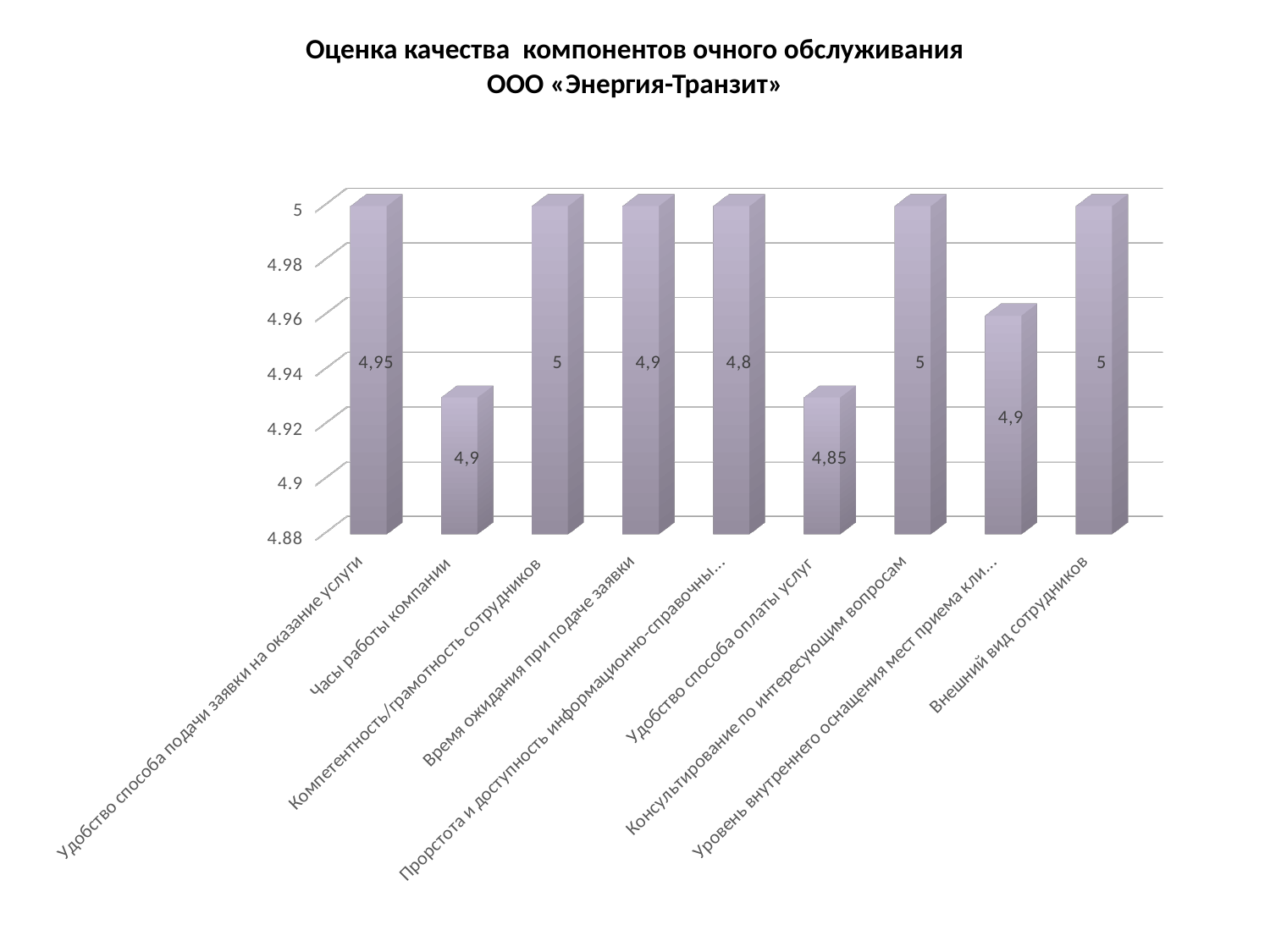
What is the value for «Компетентность/грамотность сотрудников»? 5 What type of chart is shown on the slide? bar chart What is the value for «Удобство способа оплаты услуг»? 4,85 How many categories are plotted in the chart? 9 Which has the larger value: «Компетентность/грамотность сотрудников» or «Удобство способа оплаты услуг»? Компетентность/грамотность сотрудников What is the title of the chart? Оценка качества компонентов очного обслуживания ООО «Энергия-Транзит» What is the value for «Удобство способа подачи заявки на оказание услуги»? 4,95 What is the value for «Время ожидания при подаче заявки»? 4,9 What is the value for «Внешний вид сотрудников»? 5 Is the value for «Часы работы компании» greater or less than 4.96? less What is the difference between the values for «Удобство способа подачи заявки на оказание услуги» and «Часы работы компании»? 0,05 What is the value for «Часы работы компании»? 4,9